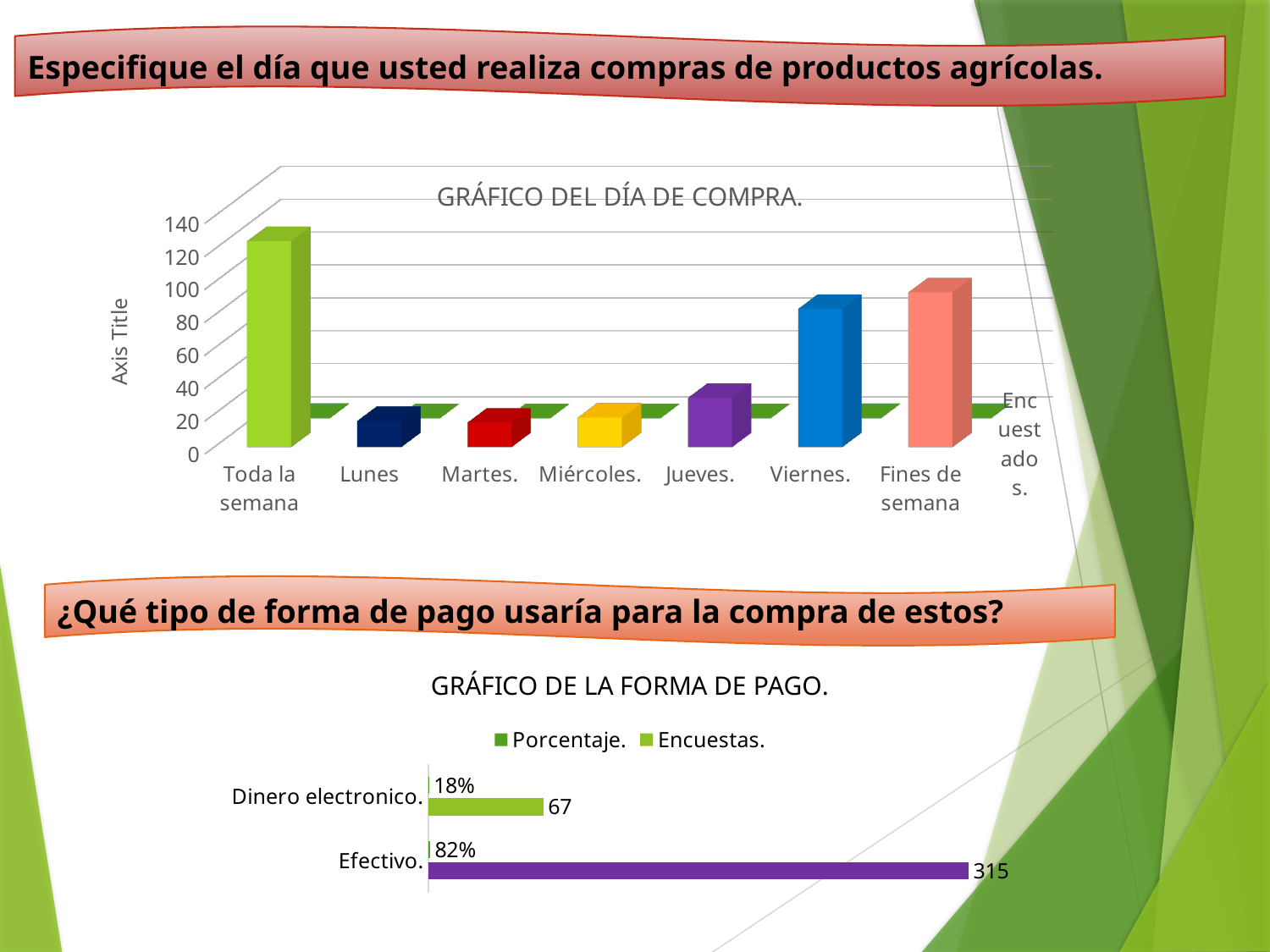
How many day categories are shown in the chart titled 'GRÁFICO DEL DÍA DE COMPRA.'? 7 In the chart titled 'GRÁFICO DEL DÍA DE COMPRA.', is the value for Toda la semana greater or less than 100? greater In the chart titled 'GRÁFICO DEL DÍA DE COMPRA.', is the value for Fines de semana greater or less than 80? greater What kind of chart is 'GRÁFICO DEL DÍA DE COMPRA.'? bar chart In the chart titled 'GRÁFICO DE LA FORMA DE PAGO.', what is the difference between the Encuestas. values for Efectivo. and Dinero electronico.? 248 In the chart titled 'GRÁFICO DE LA FORMA DE PAGO.', what is the Encuestas. value for Efectivo.? 315 In the chart titled 'GRÁFICO DE LA FORMA DE PAGO.', what is the Porcentaje. value for Dinero electronico.? 18% In the chart titled 'GRÁFICO DEL DÍA DE COMPRA.', is the value for Viernes. greater or less than 100? less In the chart titled 'GRÁFICO DEL DÍA DE COMPRA.', which day category has the highest value? Toda la semana How many series does the legend list in the chart titled 'GRÁFICO DE LA FORMA DE PAGO.'? 2 In the chart titled 'GRÁFICO DEL DÍA DE COMPRA.', which is larger, the value for Toda la semana or the value for Fines de semana? Toda la semana